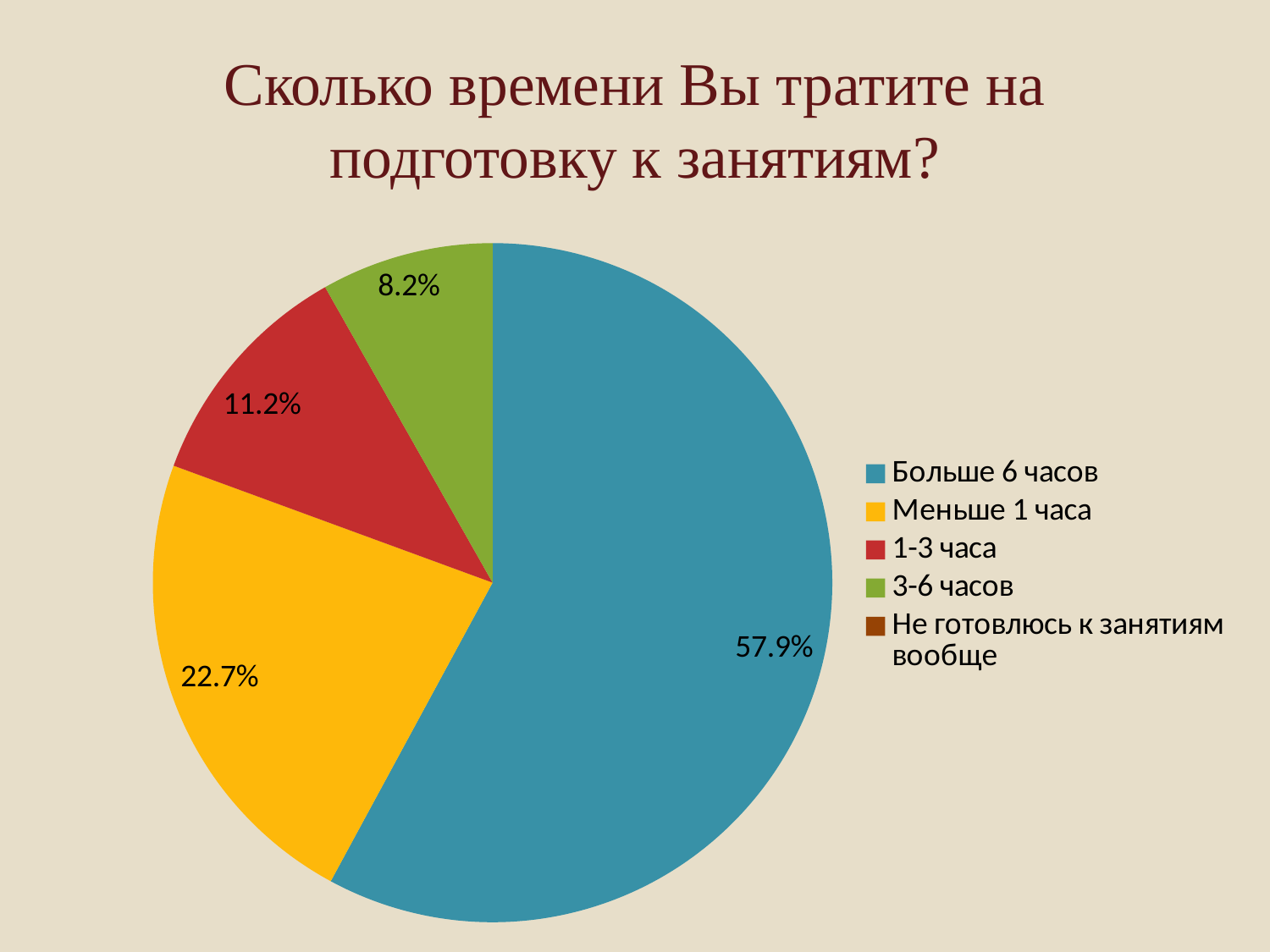
What share of the pie does "1-3 часа" take? 11.2% How many entries does the legend list? 5 Which is larger, the share for "1-3 часа" or the share for "3-6 часов"? 1-3 часа What share of the pie does "Больше 6 часов" take? 57.9% What is the title of the chart? Сколько времени Вы тратите на подготовку к занятиям? What kind of chart is shown on the slide? pie chart Which of the slices with a printed percentage is the smallest? 3-6 часов What share of the pie does "3-6 часов" take? 8.2% What is the difference in percentage points between "Больше 6 часов" and "Меньше 1 часа"? 35.2% What colour is the slice for "Меньше 1 часа"? yellow What share of the pie does "Меньше 1 часа" take? 22.7% Which category has the largest slice of the pie? Больше 6 часов